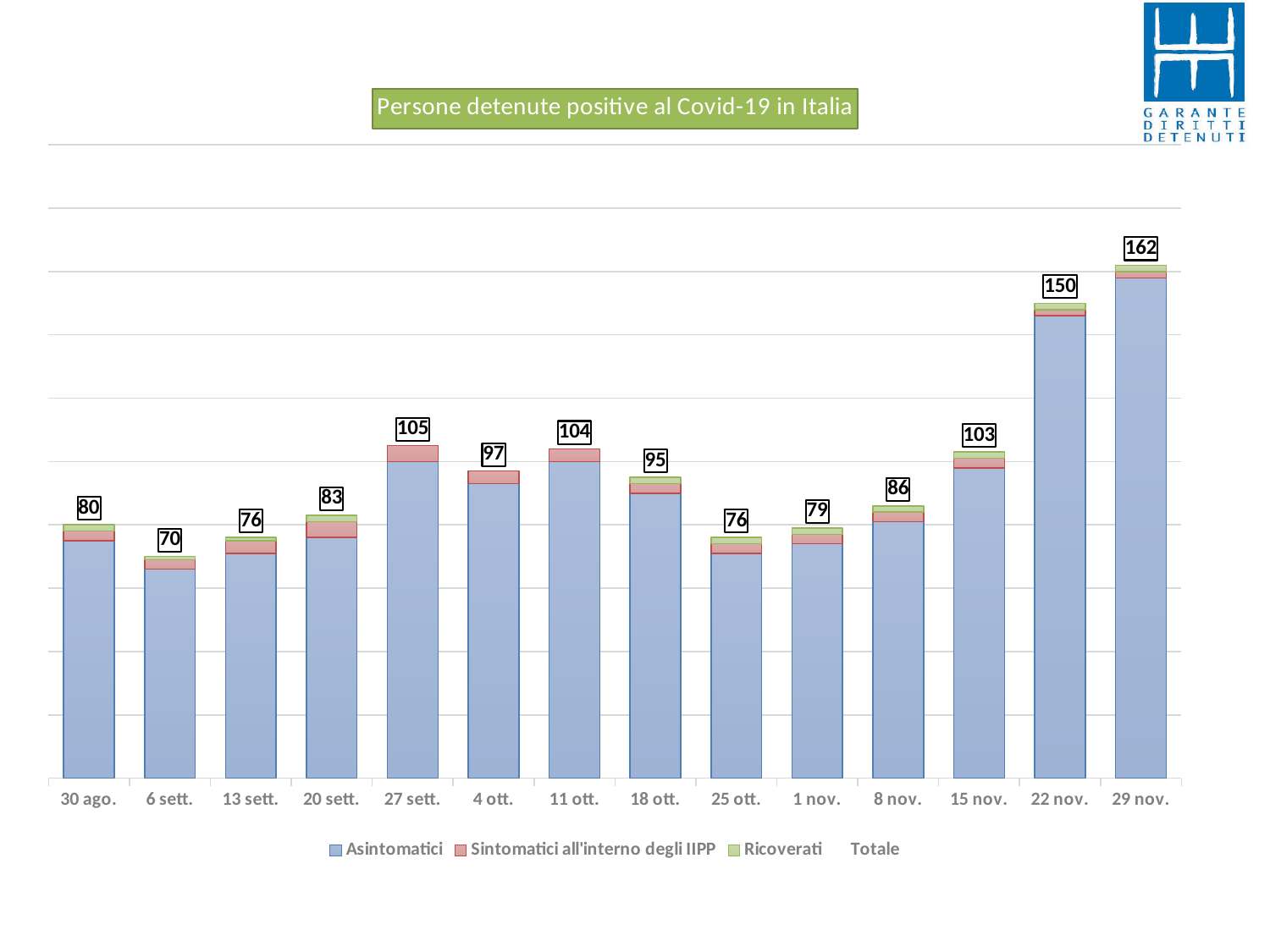
What is the total value shown for 8 nov.? 86 How many entries does the legend list? 4 Which has a larger total, 22 nov. or 15 nov.? 22 nov. Which date has the highest total? 29 nov. How many dates are shown on the x axis? 14 What is the title of the chart? Persone detenute positive al Covid-19 in Italia What is the total value shown for 27 sett.? 105 Which date has the lowest total? 6 sett. What is the total value shown for 29 nov.? 162 What is the difference between the totals for 29 nov. and 22 nov.? 12 What kind of chart is shown on the slide? Stacked bar chart What is the difference between the totals for 27 sett. and 6 sett.? 35